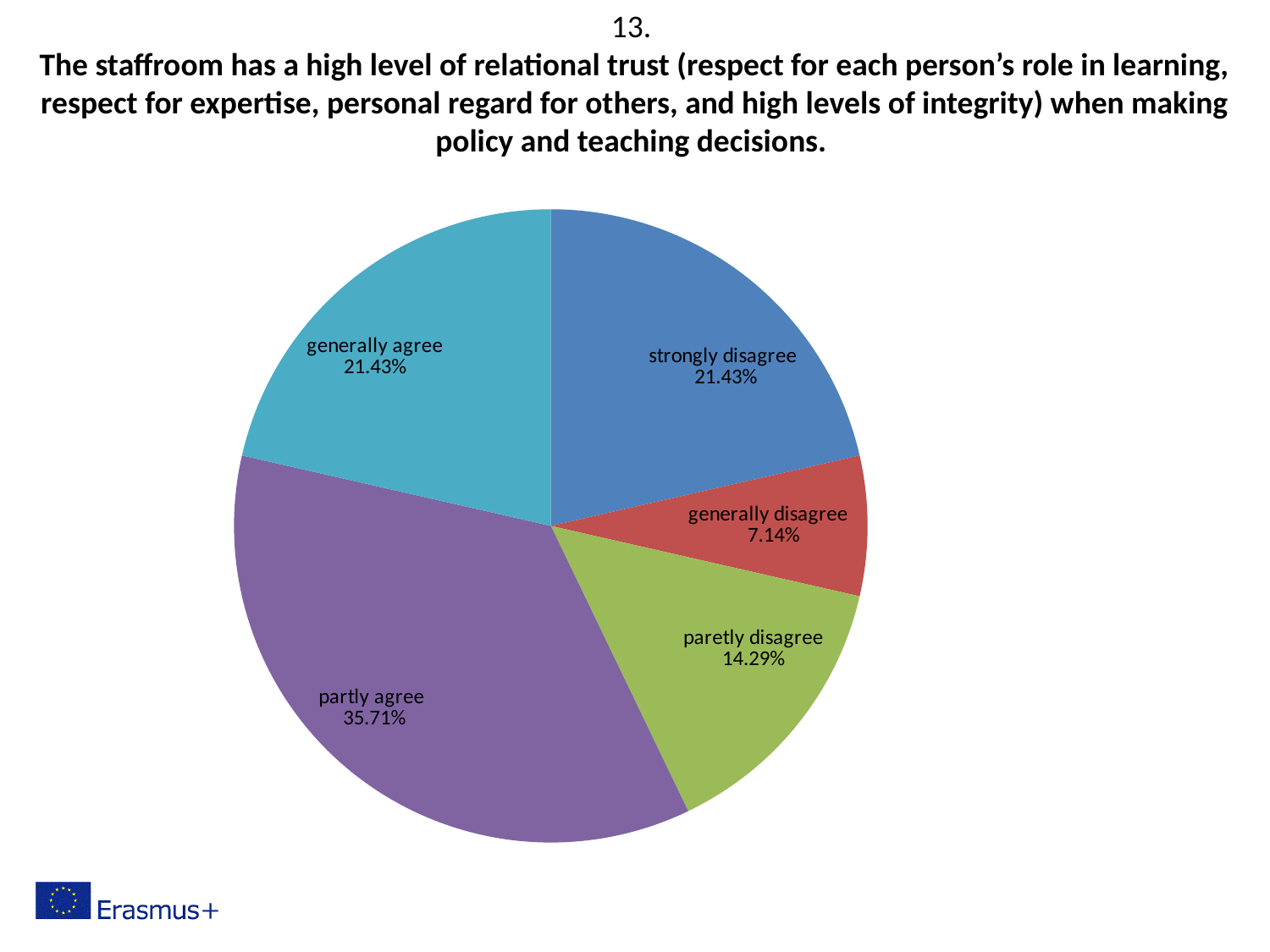
What percentage of respondents chose 'partly agree'? 35.71% Which response category has the smallest share of the pie? generally disagree What is the combined percentage of 'generally agree' and 'partly agree'? 57.14% Which response category has the largest share of the pie? partly agree What kind of chart is shown on the slide? pie chart What percentage of respondents chose 'strongly disagree'? 21.43% Which is larger, the share for 'strongly disagree' or the share for 'generally disagree'? strongly disagree What colour is the 'partly agree' slice? purple What percentage of respondents chose 'generally disagree'? 7.14% What percentage of respondents chose 'paretly disagree'? 14.29% What is the difference in percentage points between 'partly agree' and 'paretly disagree'? 21.42 How many slices does the pie chart have? 5